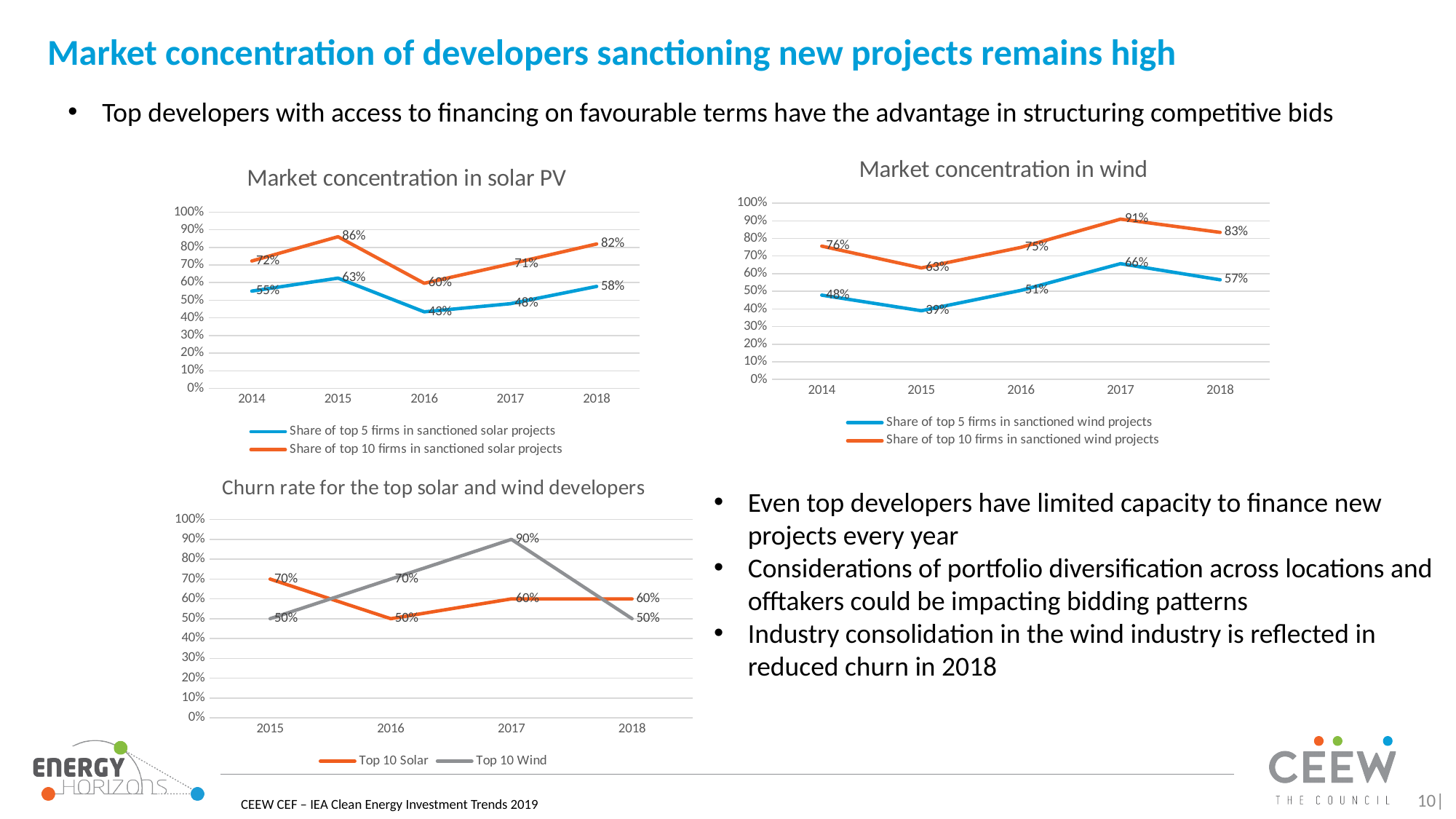
In the 'Market concentration in wind' chart, how many series does the legend list? 2 In the 'Market concentration in solar PV' chart, what is the difference between the top 10 and top 5 shares in 2018? 24% In the 'Churn rate for the top solar and wind developers' chart, which is larger in 2015, Top 10 Solar or Top 10 Wind? Top 10 Solar In the 'Market concentration in wind' chart, what is the share of top 5 firms in sanctioned wind projects in 2015? 39% In the 'Market concentration in wind' chart, what is the share of top 10 firms in sanctioned wind projects in 2017? 91% In the 'Churn rate for the top solar and wind developers' chart, how many years are shown on the x axis? 4 In the 'Churn rate for the top solar and wind developers' chart, what is the Top 10 Wind churn rate in 2017? 90% In the 'Market concentration in wind' chart, in which year is the share of top 5 firms highest? 2017 In the 'Market concentration in solar PV' chart, in which year is the share of top 5 firms lowest? 2016 In the 'Market concentration in solar PV' chart, what is the share of top 5 firms in sanctioned solar projects in 2016? 43% In the 'Market concentration in solar PV' chart, what is the share of top 10 firms in sanctioned solar projects in 2015? 86% What kind of chart is the 'Market concentration in solar PV' chart? Line chart